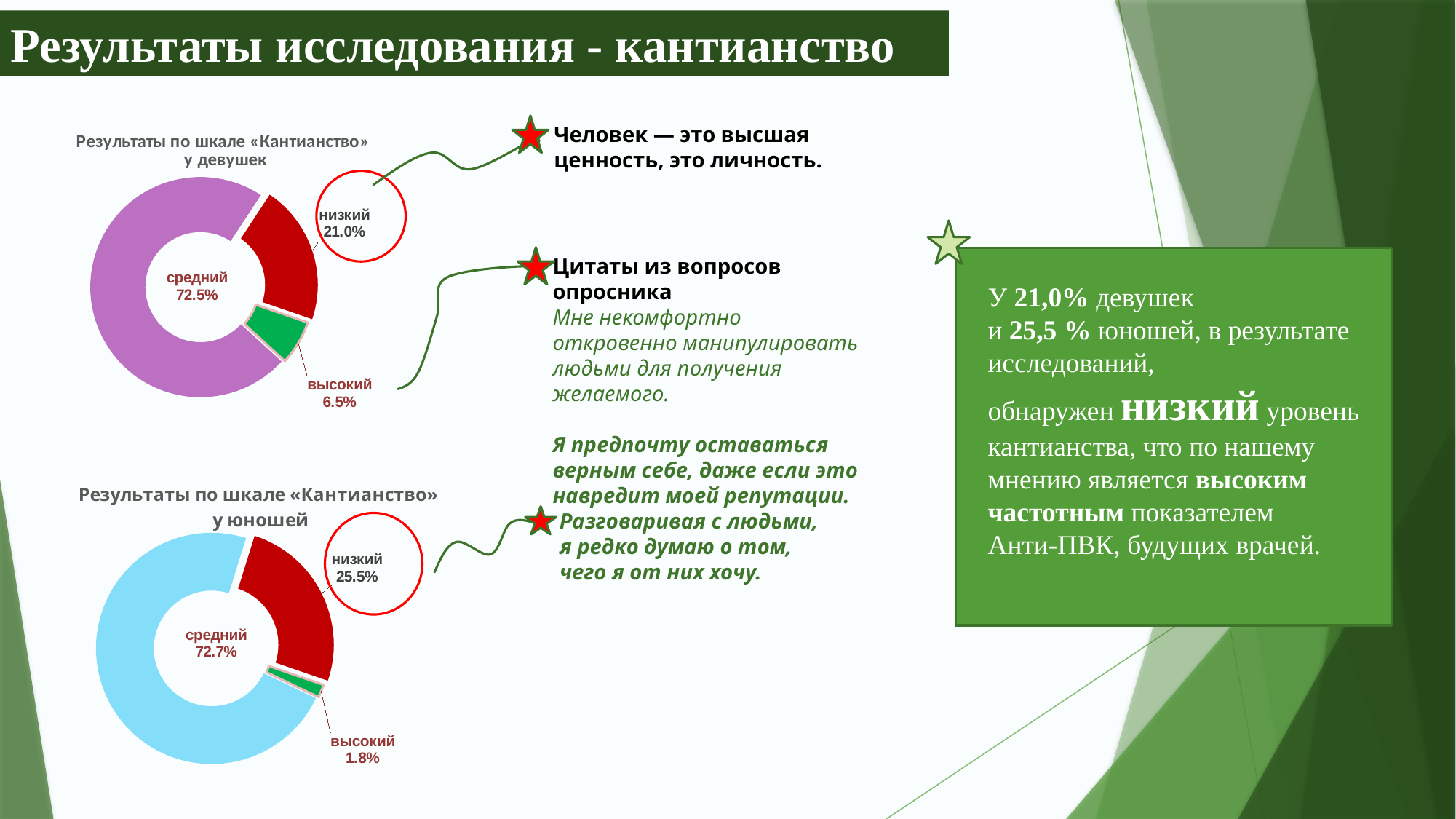
In the chart «Результаты по шкале «Кантианство» у юношей», which category has the smallest share? высокий What type of chart is «Результаты по шкале «Кантианство» у юношей»? Pie (donut) chart Which is larger: «низкий» in the chart for девушек or «низкий» in the chart for юношей? юношей (25.5%) In the chart «Результаты по шкале «Кантианство» у девушек», what is the difference between «средний» and «низкий»? 51.5% In the chart «Результаты по шкале «Кантианство» у юношей», what is the value for «высокий»? 1.8% In the chart «Результаты по шкале «Кантианство» у девушек», which category has the largest share? средний In the chart «Результаты по шкале «Кантианство» у девушек», what is the value for «низкий»? 21.0% What colour is the «средний» slice in the chart «Результаты по шкале «Кантианство» у юношей»? Light blue In the chart «Результаты по шкале «Кантианство» у юношей», what is the value for «низкий»? 25.5% How many categories does the chart «Результаты по шкале «Кантианство» у девушек» show? 3 In the chart «Результаты по шкале «Кантианство» у юношей», what is the difference between «низкий» and «высокий»? 23.7% In the chart «Результаты по шкале «Кантианство» у девушек», what is the value for «средний»? 72.5%